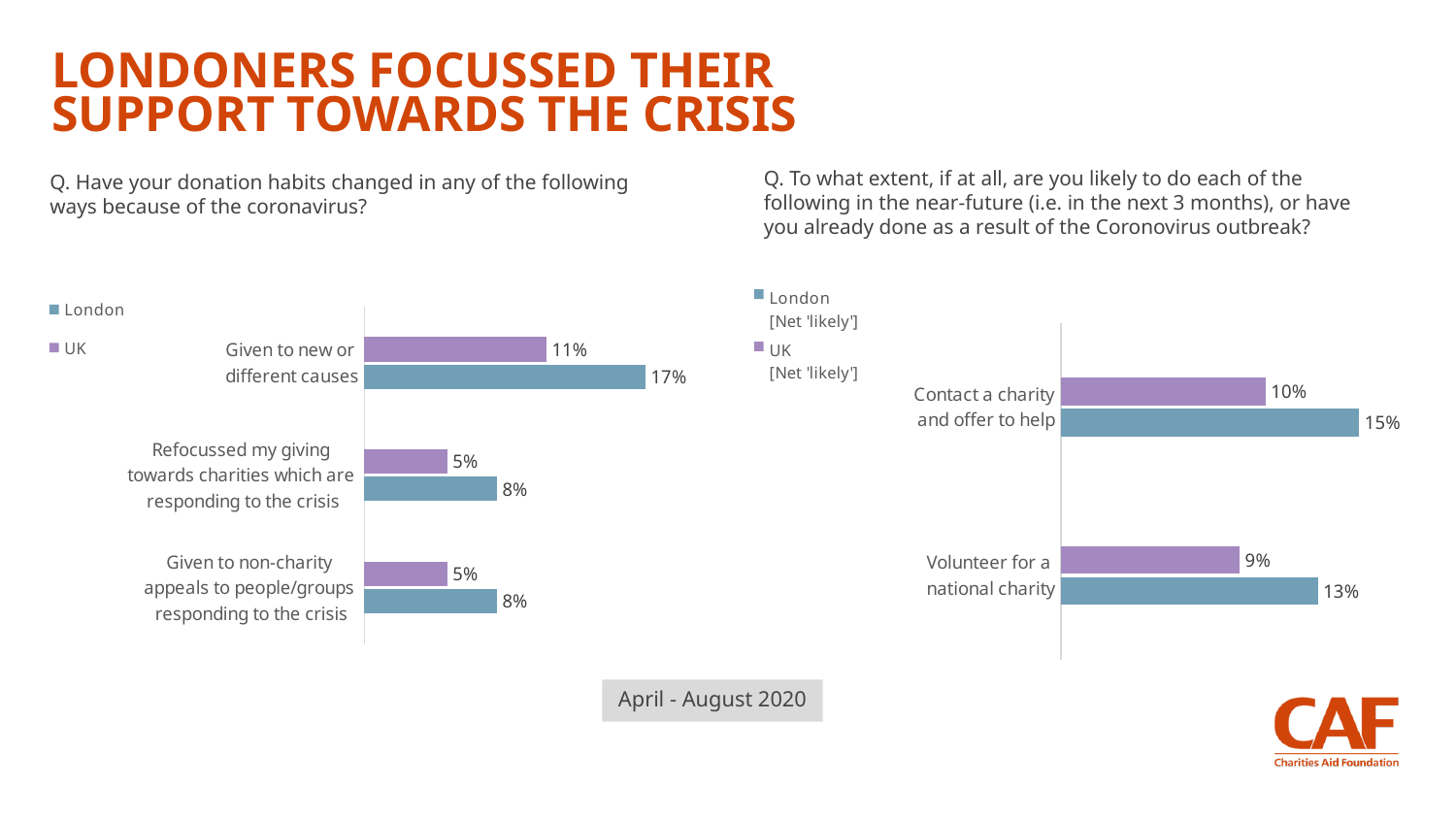
In the left chart, which category has the highest London value? Given to new or different causes In the right chart, what is the London value for 'Contact a charity and offer to help'? 15% In the right chart, which is larger: the London value or the UK value for 'Volunteer for a national charity'? London How many categories are shown in the left chart? 3 In the right chart, what is the difference between the London and UK values for 'Contact a charity and offer to help'? 5% In the left chart, what is the difference between the London and UK values for 'Given to new or different causes'? 6% In the left chart, what is the London value for 'Given to new or different causes'? 17% In the right chart, what is the UK value for 'Volunteer for a national charity'? 9% In the left chart, what is the UK value for 'Given to new or different causes'? 11% In the left chart, what is the London value for 'Refocussed my giving towards charities which are responding to the crisis'? 8% In the left chart, what is the UK value for 'Given to non-charity appeals to people/groups responding to the crisis'? 5% What type of chart is the right chart? Bar chart